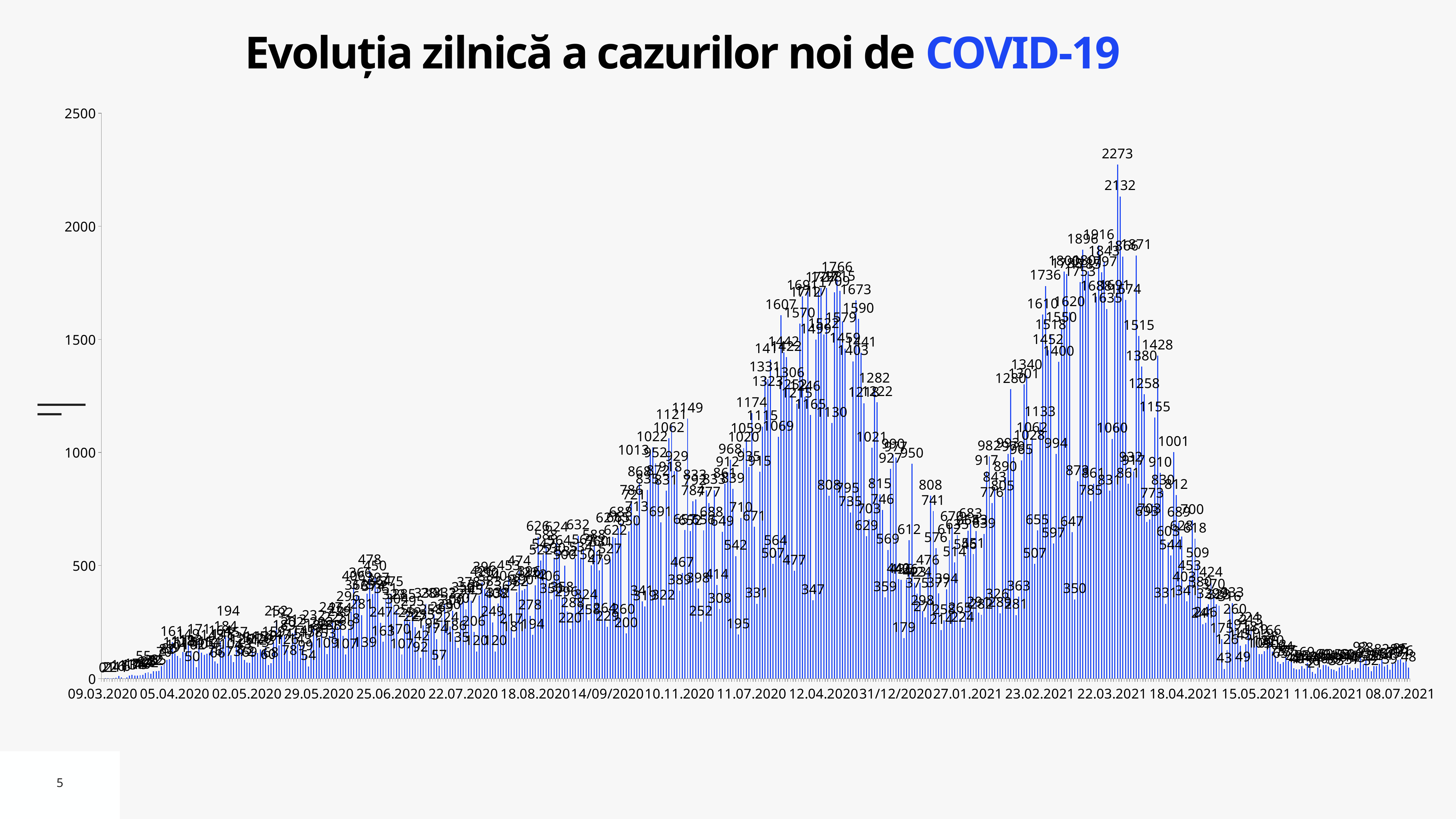
What is the title of the chart? Evoluția zilnică a cazurilor noi de COVID-19 Which is larger: the peak of the late-2020 wave (1766) or the peak of the spring-2021 wave (2273)? 2273 What is the data label on the bar immediately to the right of the tallest bar (2273)? 2132 What is the highest daily value labelled on the chart? 2273 Do the values generally rise or fall between the 09.03.2020 and 25.06.2020 axis labels? rise What is the highest data label in the first small wave, near the 25.06.2020 axis label? 478 What is the last date label shown on the x axis? 08.07.2021 What is the highest data label in the second-largest peak of the chart (the late-2020 wave)? 1766 Is the tallest bar on the chart greater or less than 2000? greater What kind of chart is shown on the slide? bar chart Do the values generally rise or fall between the 22.03.2021 and 08.07.2021 axis labels? fall What is the difference between the two highest labelled values, 2273 and 2132? 141